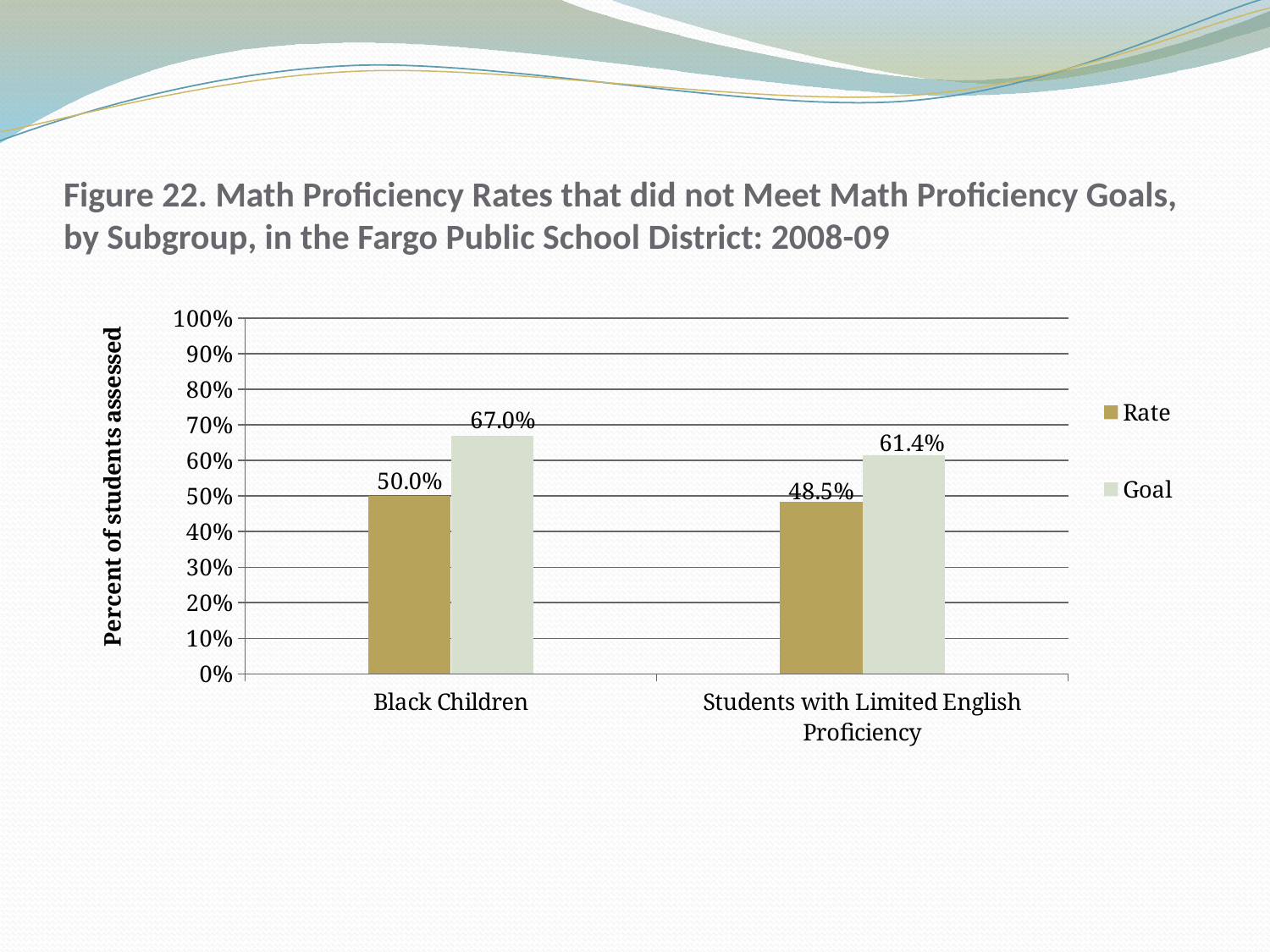
Which subgroup has the lower Rate value? Students with Limited English Proficiency Which subgroup has the higher Goal value? Black Children What is the difference between the Goal and the Rate for Students with Limited English Proficiency? 12.9% What is the Rate value for Black Children? 50.0% How many subgroups are shown on the x axis? 2 How many series does the legend list? 2 What is the Rate value for Students with Limited English Proficiency? 48.5% What is the Goal value for Students with Limited English Proficiency? 61.4% Is the Rate for Black Children larger or smaller than the Goal for Black Children? smaller What kind of chart is shown on the slide? bar chart What is the Goal value for Black Children? 67.0% What is the difference between the Goal and the Rate for Black Children? 17.0%